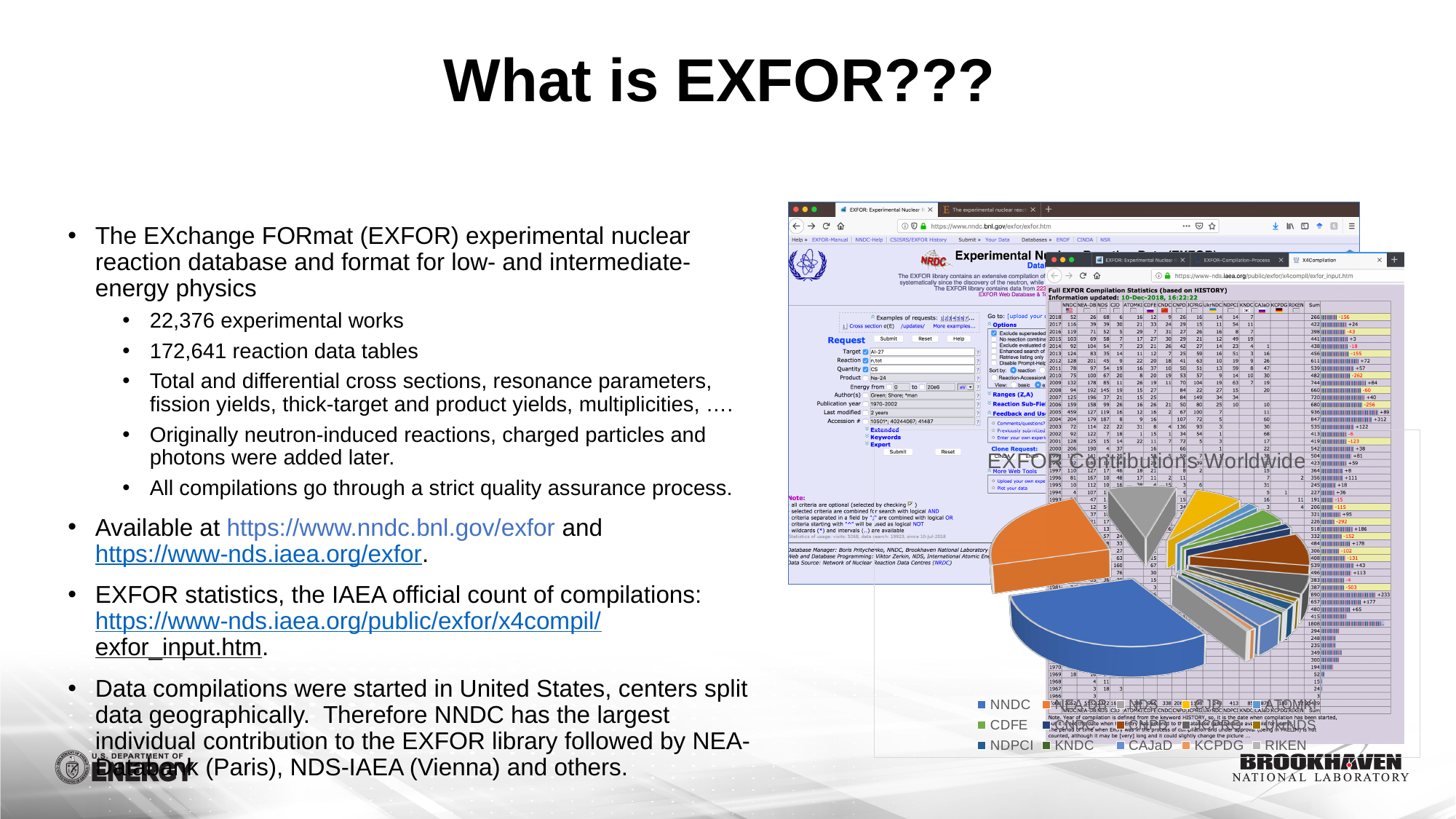
In the 'EXFOR Contributions Worldwide' pie chart, which has the larger slice, NNDC or CDFE? NNDC What is the title of the pie chart on the slide? EXFOR Contributions Worldwide What kind of chart is the 'EXFOR Contributions Worldwide' chart? pie chart In the 'EXFOR Contributions Worldwide' pie chart, which data centre has the largest slice? NNDC In the 'EXFOR Contributions Worldwide' pie chart, which has the larger slice, NNDC or RIKEN? NNDC In the 'EXFOR Contributions Worldwide' pie chart, which has the larger slice, NNDC or KNDC? NNDC In the 'EXFOR Contributions Worldwide' pie chart, which colour represents NNDC in the legend? blue